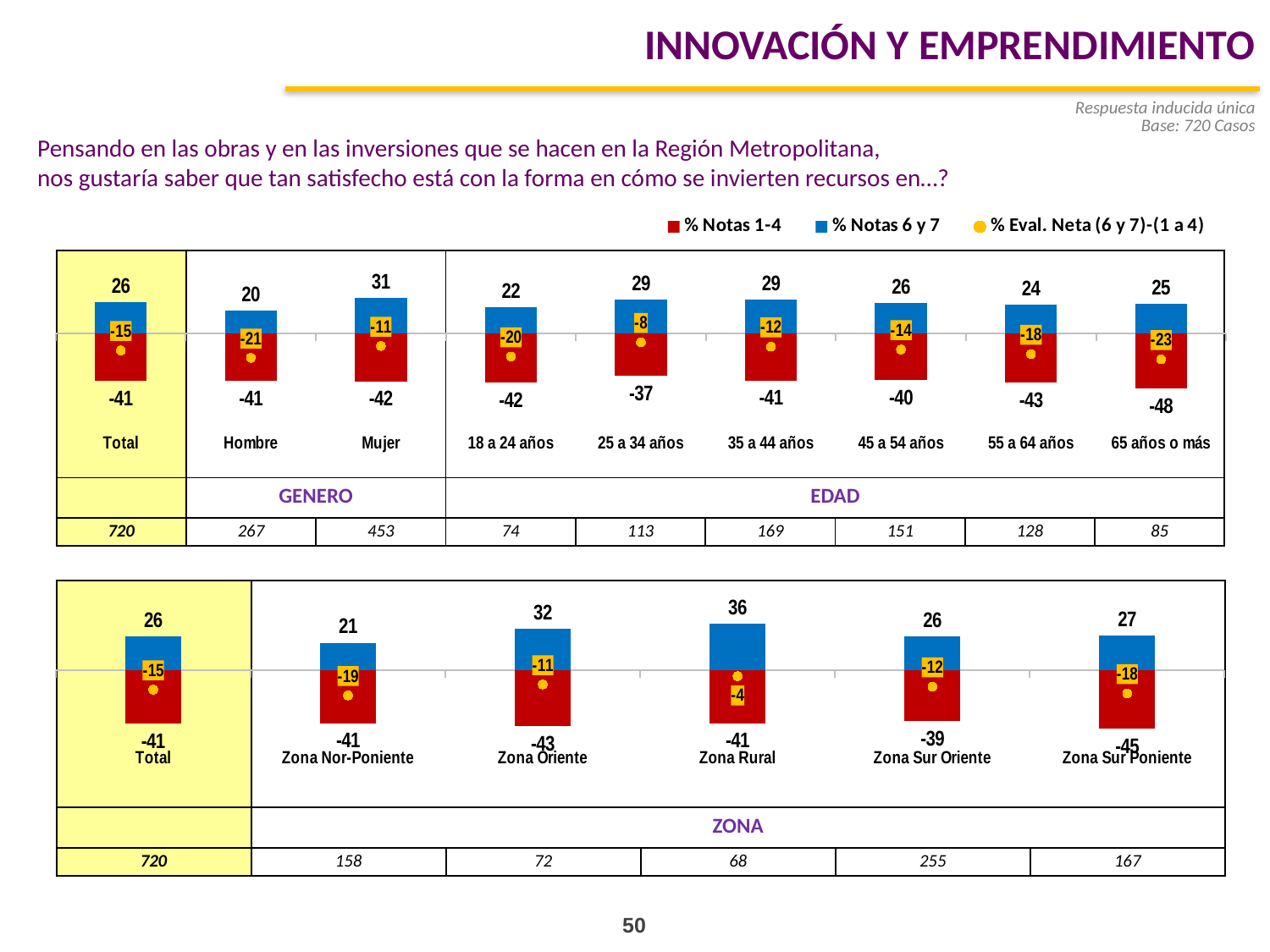
In the top chart, which age group has the lowest % Notas 1-4 value? 65 años o más What kind of chart is used on this slide? Bar chart In the top chart, what is the % Eval. Neta value for 25 a 34 años? -8 How many series does the legend list? 3 In the bottom chart, what is the % Notas 6 y 7 value for Zona Rural? 36 In the bottom chart, which has a larger % Notas 6 y 7 value, Zona Oriente or Zona Nor-Poniente? Zona Oriente In the top chart, what is the % Notas 6 y 7 value for Mujer? 31 In the top chart, what is the difference between the % Notas 6 y 7 values for Mujer and Hombre? 11 In the top chart, what is the % Notas 1-4 value for 65 años o más? -48 In the bottom chart, what is the % Eval. Neta value for Zona Sur Poniente? -18 In the bottom chart, which zona has the highest % Notas 6 y 7 value? Zona Rural In the bottom chart, how many zona categories are shown (excluding Total)? 5